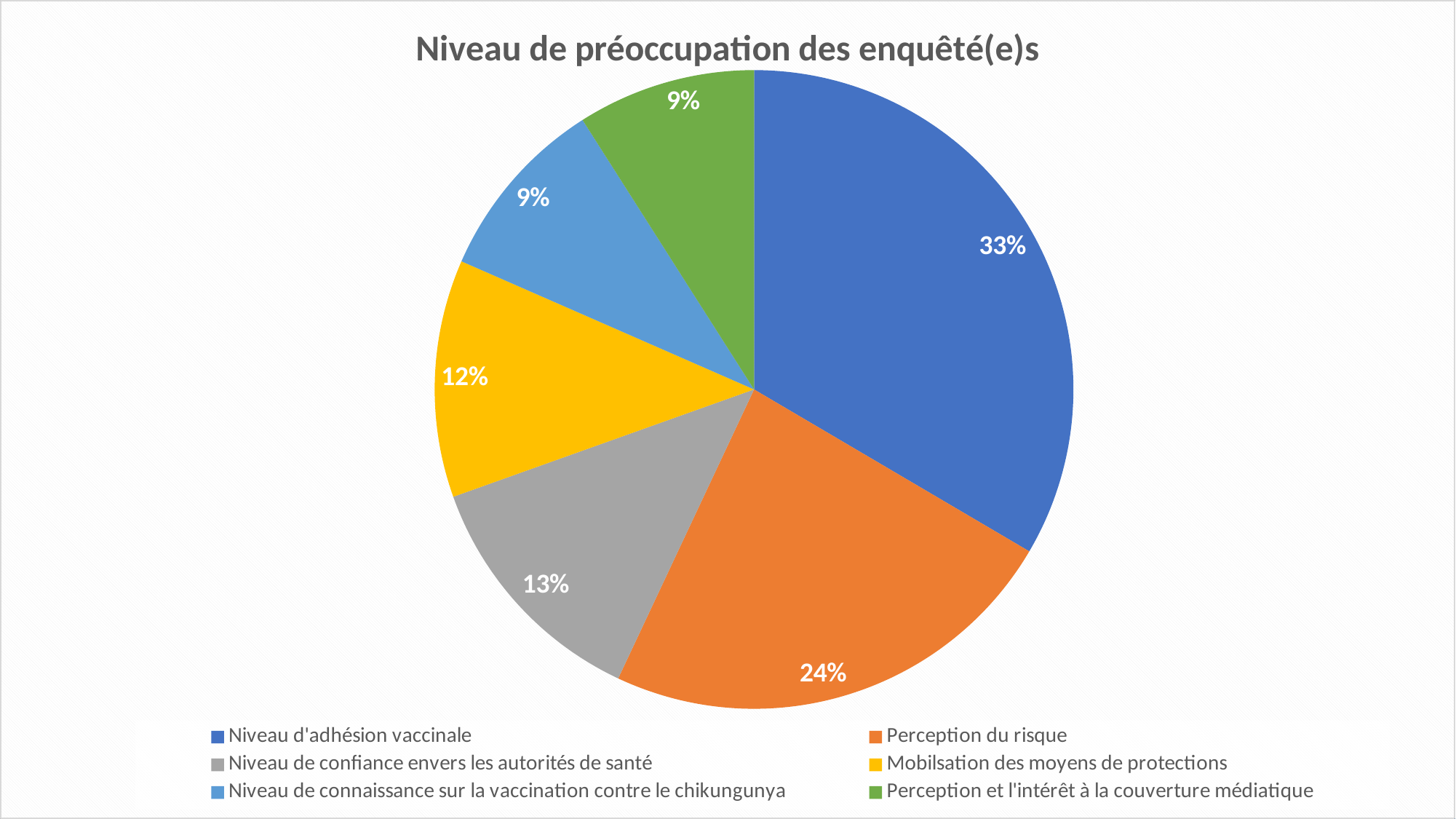
What kind of chart is shown on the slide? Pie chart What is the title of the chart? Niveau de préoccupation des enquêté(e)s What is the difference in percentage points between "Niveau d'adhésion vaccinale" and "Perception du risque"? 9 What share of the pie does "Niveau d'adhésion vaccinale" represent? 33% What share of the pie does "Niveau de confiance envers les autorités de santé" represent? 13% What share of the pie does "Perception du risque" represent? 24% Which category has the largest slice of the pie? Niveau d'adhésion vaccinale What colour is the slice for "Perception du risque"? Orange How many slices does the pie chart have? 6 What share of the pie does "Mobilsation des moyens de protections" represent? 12% Which is larger: "Niveau de confiance envers les autorités de santé" or "Mobilsation des moyens de protections"? Niveau de confiance envers les autorités de santé What share of the pie does "Perception et l'intérêt à la couverture médiatique" represent? 9%